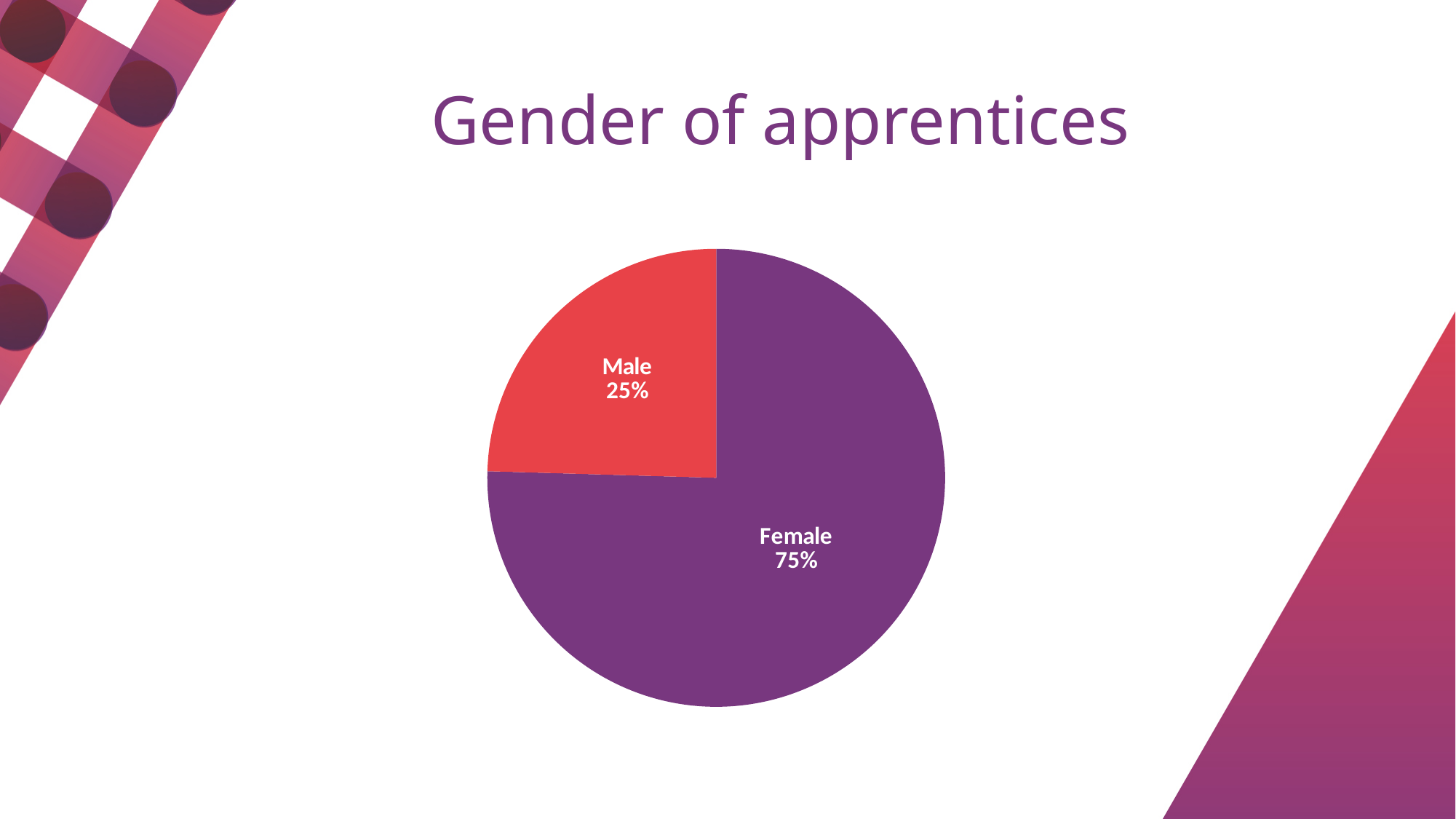
What is the difference in percentage points between the Female and Male shares? 50 What colour is the Male slice? red Which is larger, the Male share or the Female share? Female What percentage of apprentices are male? 25% What type of chart is shown on the slide? pie chart Which gender has the smallest share of apprentices? Male Which gender has the largest share of apprentices? Female What percentage of apprentices are female? 75% What share of the pie does the Male slice represent? 25% What is the title of the chart? Gender of apprentices How many slices does the pie chart have? 2